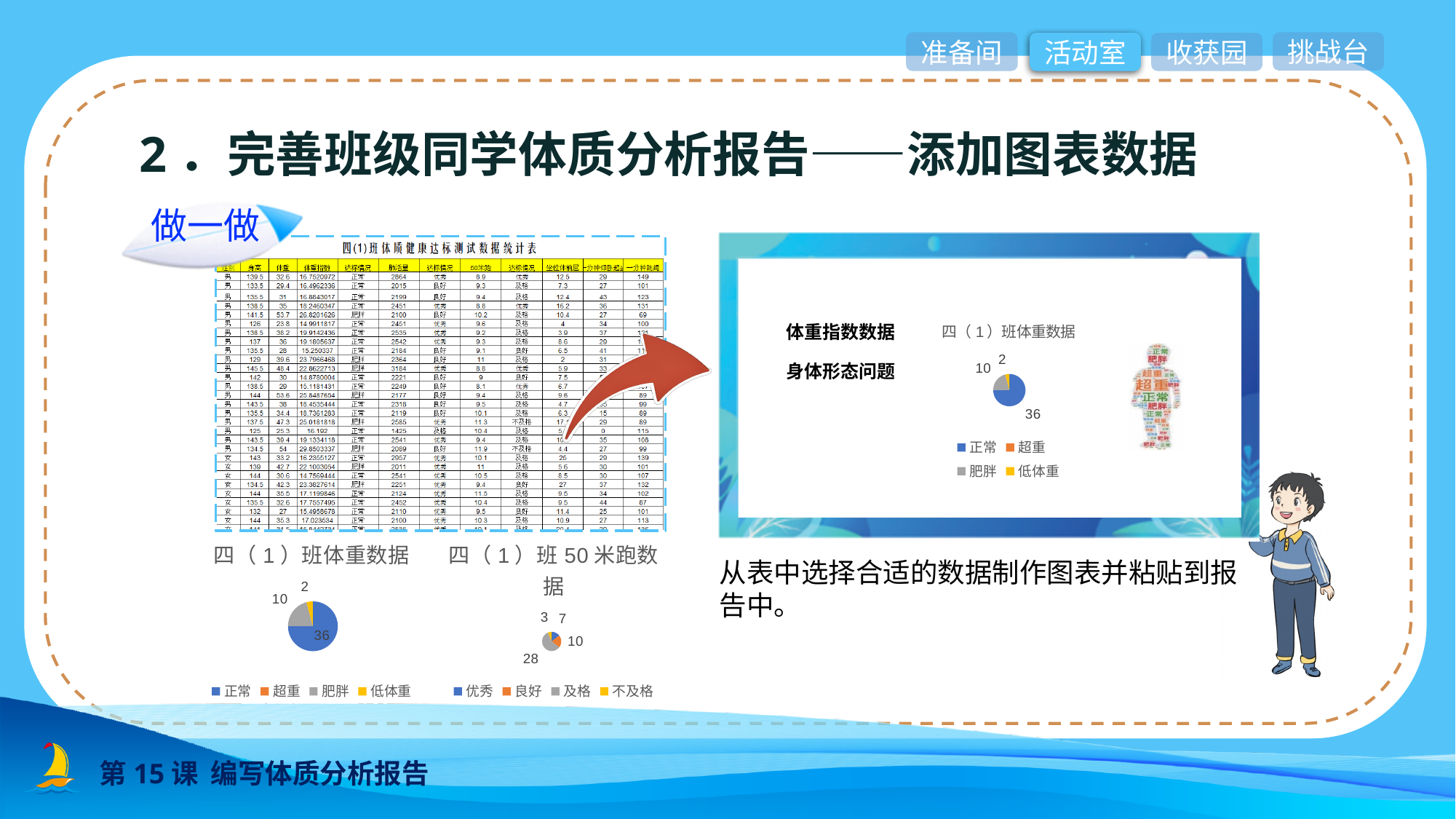
In the "四（1）班 50 米跑数据" pie chart, which is larger, the value for 良好 or the value for 优秀? 良好 What type of chart is the "四（1）班体重数据" chart at the bottom left of the slide? pie chart In the "四（1）班 50 米跑数据" pie chart, what colour represents 及格 in the legend? gray In the "四（1）班体重数据" pie chart at the bottom left, which category has the largest slice? 正常 In the "四（1）班体重数据" pie chart at the bottom left, what is the difference between the values for 正常 and 肥胖? 26 In the "四（1）班体重数据" pie chart at the bottom left, what is the value for 肥胖? 10 In the "四（1）班 50 米跑数据" pie chart, what is the value for 及格? 28 In the "四（1）班体重数据" pie chart at the bottom left, what is the value for 正常? 36 In the "四（1）班 50 米跑数据" pie chart, what is the value for 优秀? 7 In the "四（1）班 50 米跑数据" pie chart, which category has the smallest slice? 不及格 In the "四（1）班 50 米跑数据" pie chart, what is the value for 良好? 10 How many categories does the legend of the "四（1）班体重数据" pie chart at the bottom left list? 4